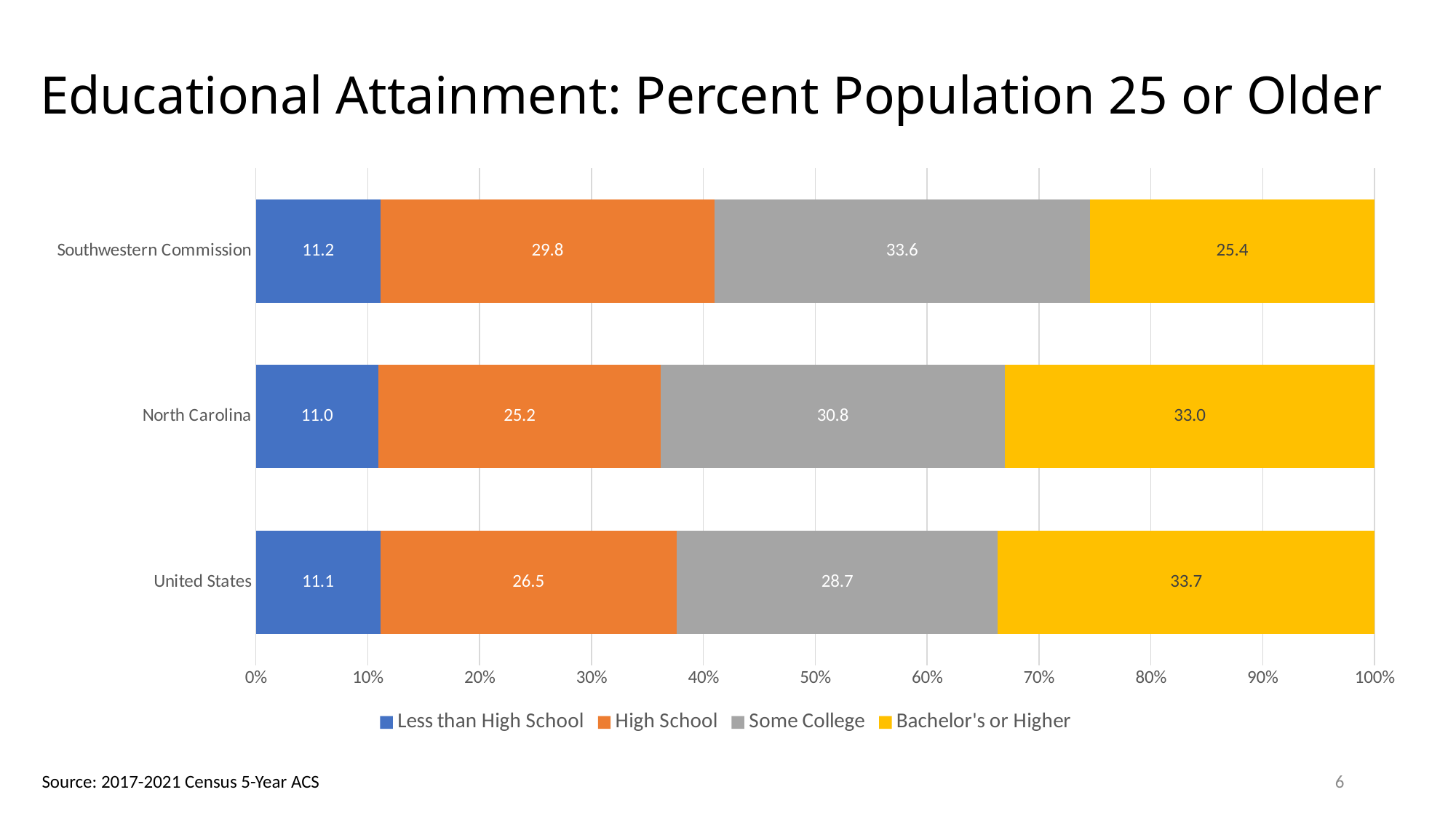
What is the Bachelor's or Higher value for North Carolina? 33.0 What is the Some College value for United States? 28.7 How many categories are shown on the y axis? 3 What is the Less than High School value for Southwestern Commission? 11.2 What kind of chart is shown on the slide? Stacked bar chart Which category has the highest Some College value? Southwestern Commission What is the title of the chart? Educational Attainment: Percent Population 25 or Older What is the High School value for Southwestern Commission? 29.8 Which is larger, the High School value for Southwestern Commission or for North Carolina? Southwestern Commission What is the difference between the Bachelor's or Higher values for United States and Southwestern Commission? 8.3 Which category has the lowest Bachelor's or Higher value? Southwestern Commission How many series does the legend list? 4